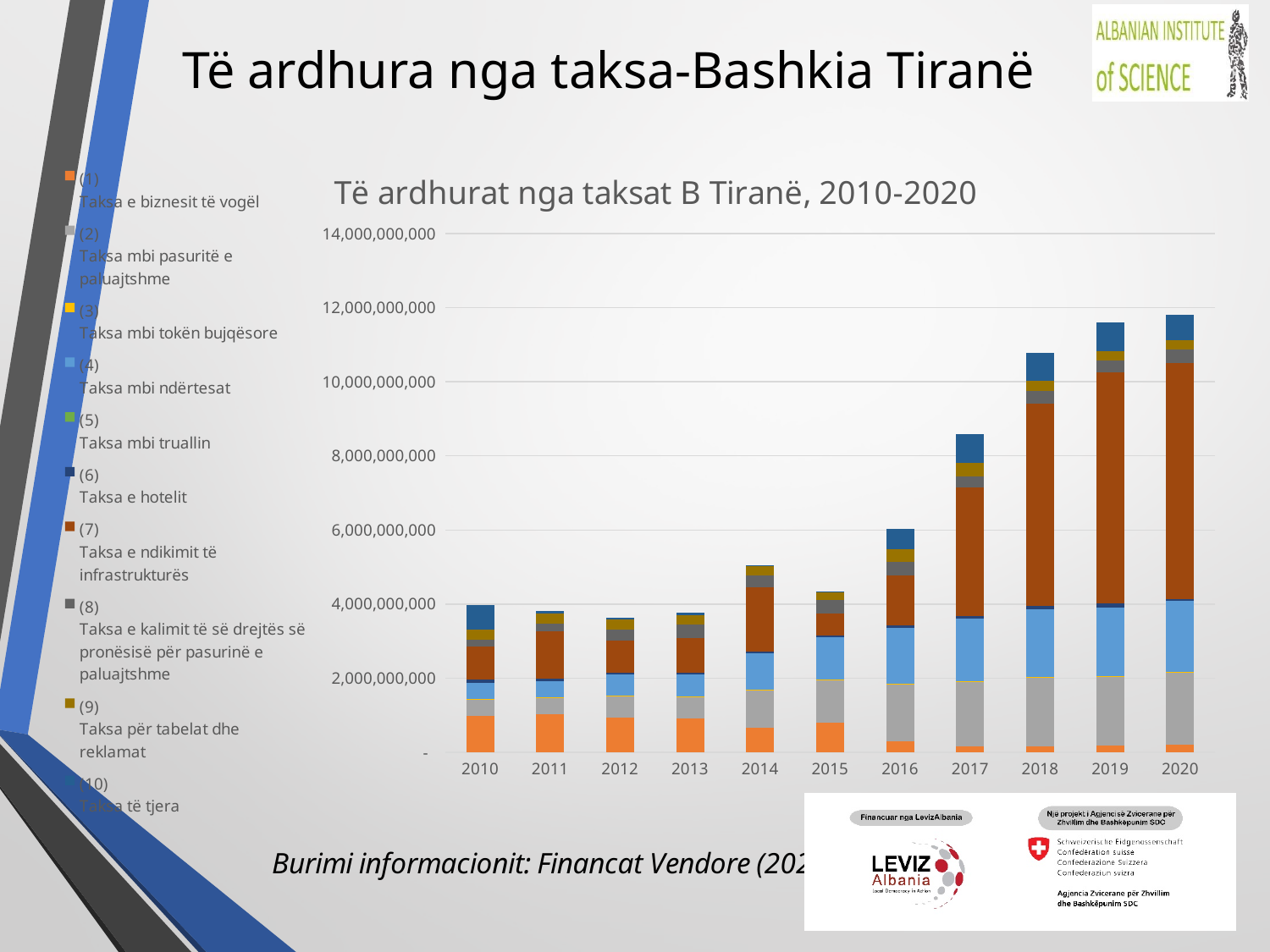
Is the total value of the bar for 2017 greater or less than 8,000,000,000? greater What is the title of the chart? Të ardhurat nga taksat B Tiranë, 2010-2020 Is the total value of the bar for 2020 greater or less than 10,000,000,000? greater Do the total tax revenues generally rise or fall from 2010 to 2020? Rise Which legend entry is listed first in the chart legend? (1) Taksa e biznesit të vogël Is the total value of the bar for 2014 greater or less than 6,000,000,000? less How many series does the chart legend list? 10 What kind of chart is shown on the slide? Stacked bar chart How many years (categories) are shown on the x axis of the chart? 11 Which year has the larger total bar, 2010 or 2020? 2020